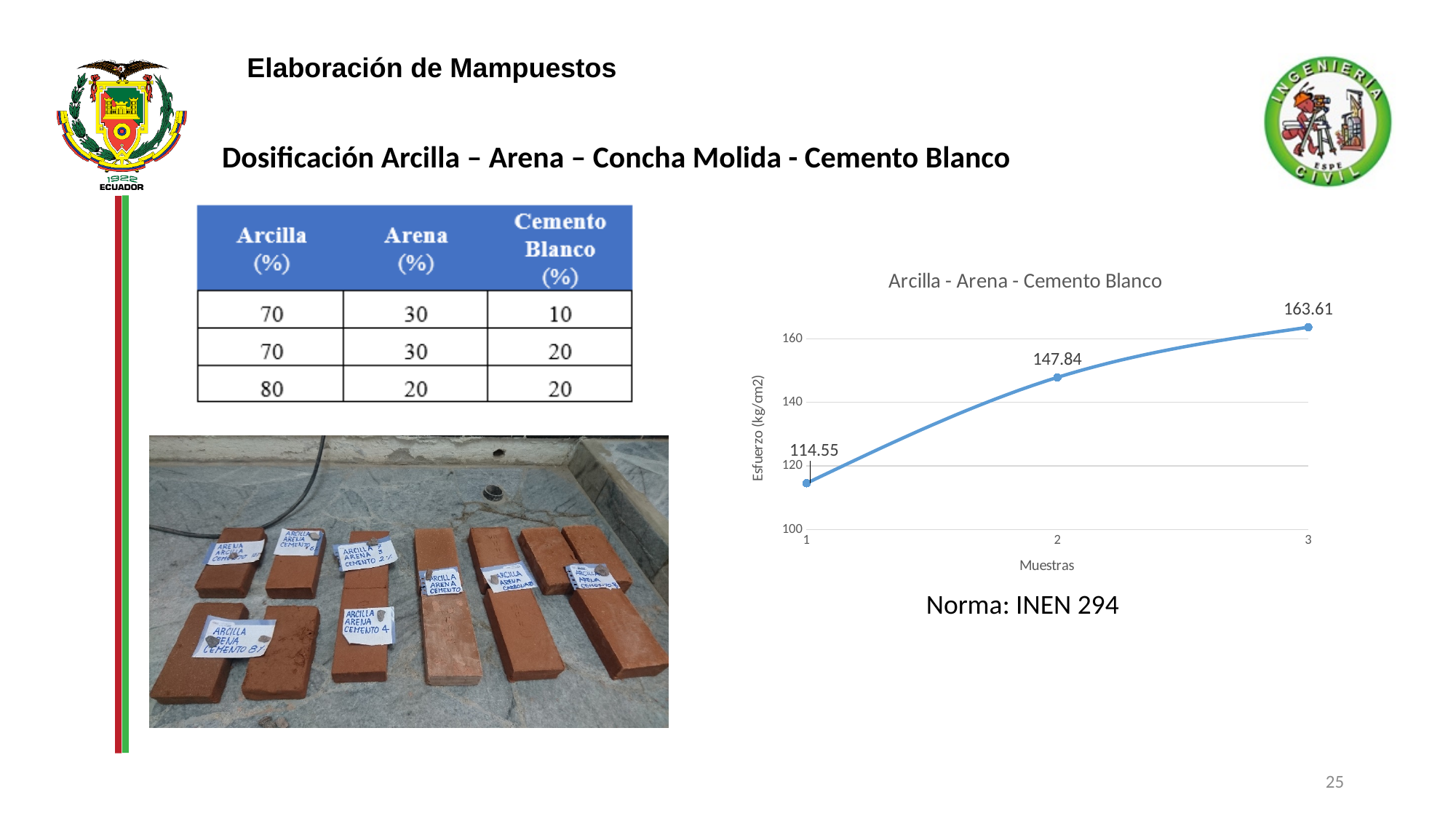
What is the value for Muestra 1 in the chart? 114.55 Do the values rise or fall from Muestra 1 to Muestra 3? rise What is the value for Muestra 2 in the chart? 147.84 Which is larger, the value for Muestra 2 or Muestra 3? Muestra 3 Which Muestra has the highest Esfuerzo value? 3 Which Muestra has the lowest Esfuerzo value? 1 How many data points are plotted in the chart? 3 What is the difference between the values for Muestra 3 and Muestra 1? 49.06 Is the value for Muestra 2 greater or less than 140? greater What is the value for Muestra 3 in the chart? 163.61 What kind of chart is shown on the slide? line chart What is the difference between the values for Muestra 2 and Muestra 1? 33.29